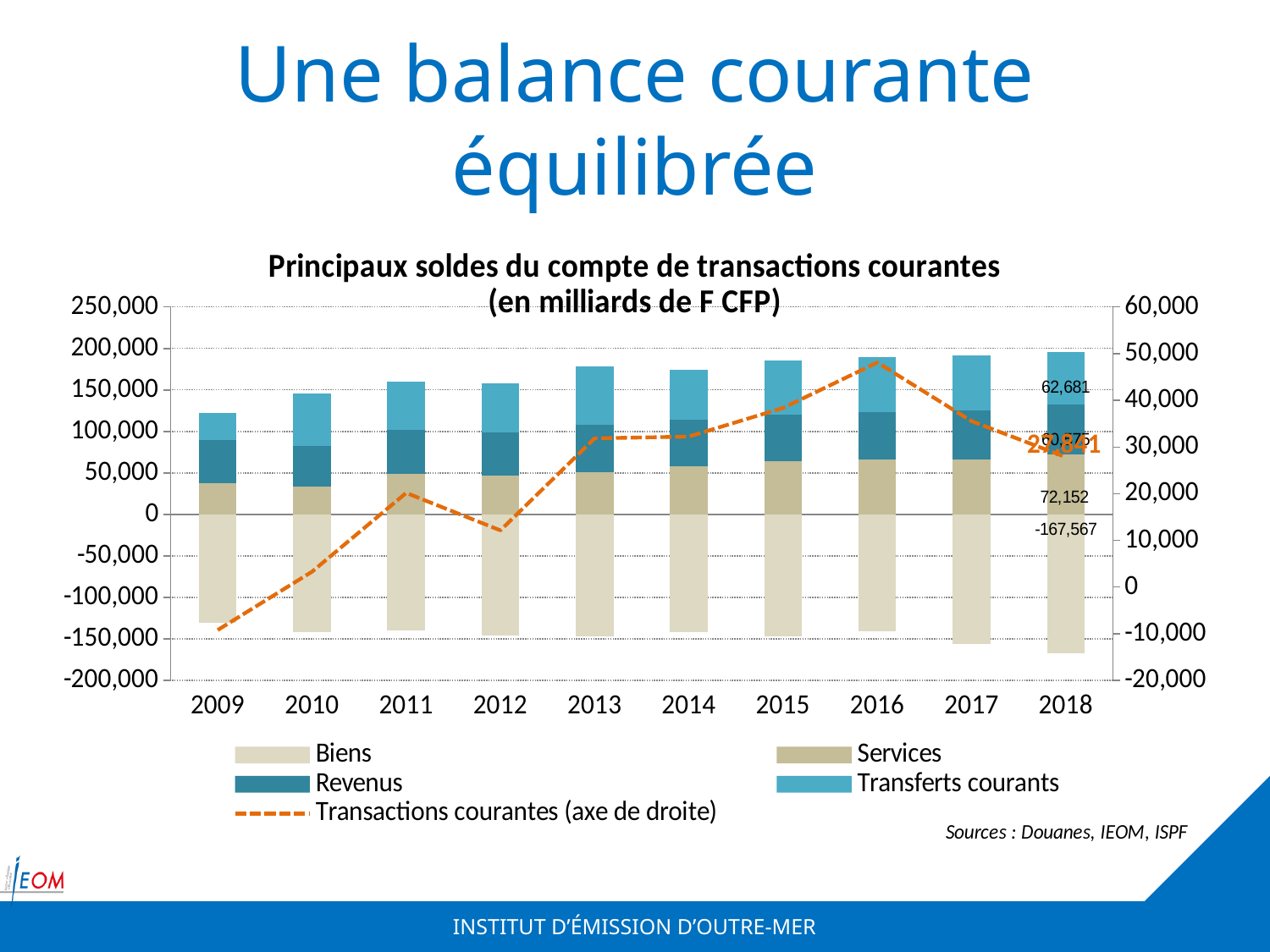
In which year does the Transactions courantes line reach its highest point? 2016 How many years are shown on the x axis of the chart? 10 What is the value of Services in 2018? 72,152 What is the value of Transferts courants in 2018? 62,681 What kind of chart is shown on the slide? Stacked bar chart with a line In 2018, which is larger: Services or Transferts courants? Services How many series does the chart legend list? 5 What is the value of Biens in 2018? -167,567 What is the difference between Services and Transferts courants in 2018? 9,471 Which series is plotted on the right axis according to the legend? Transactions courantes In which year is the Transactions courantes line at its lowest point? 2009 Is the value for Biens in 2009 greater or less than -100,000? less